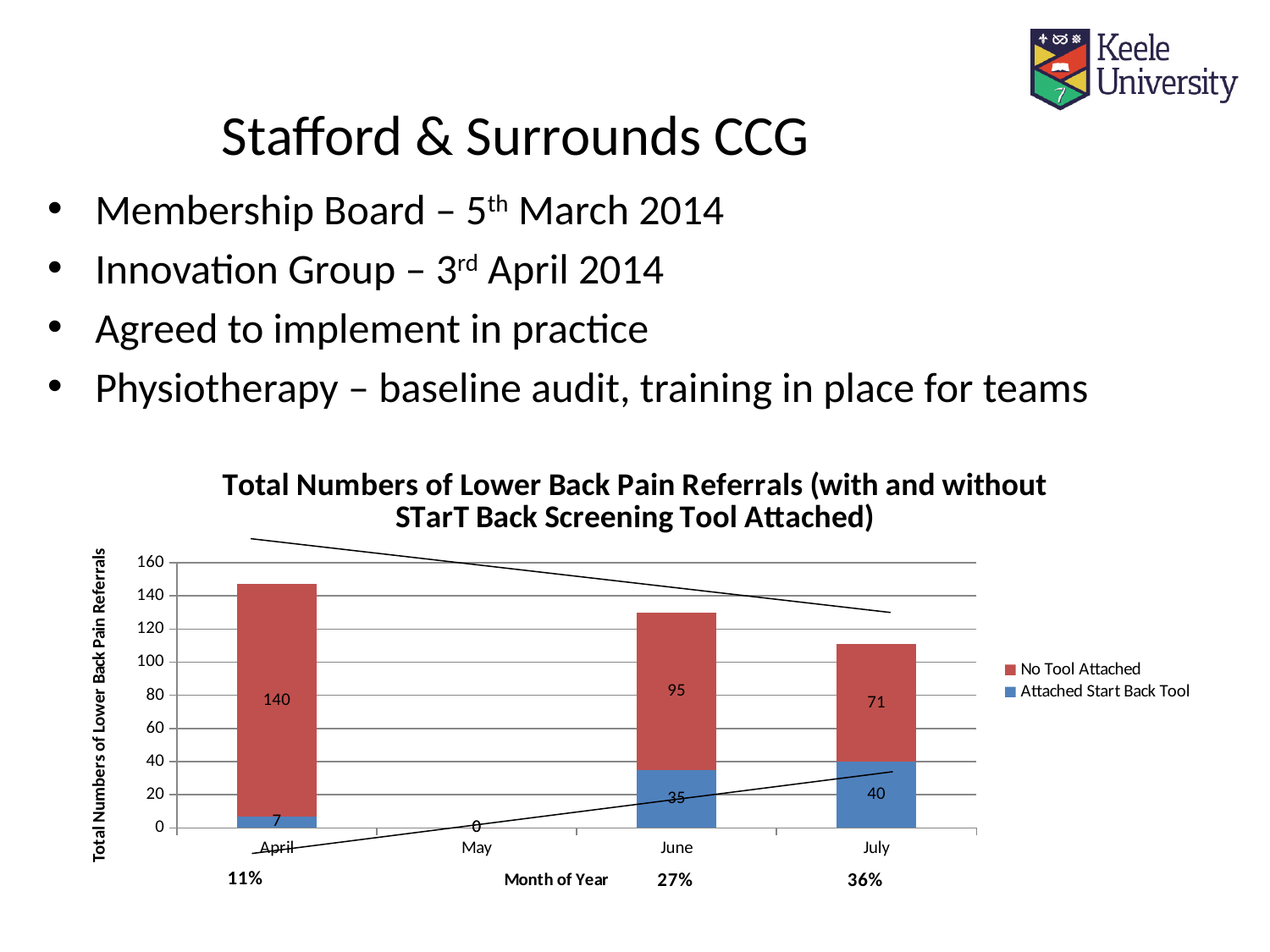
What is the title of the chart? Total Numbers of Lower Back Pain Referrals (with and without STarT Back Screening Tool Attached) What is the value for No Tool Attached in April? 140 How many series does the chart legend list? 2 What kind of chart is shown on the slide? stacked bar chart What is the value for Attached Start Back Tool in July? 40 Which month has the highest value for No Tool Attached? April What is the total of the stacked bar for June? 130 What is the value for No Tool Attached in July? 71 What is the value for Attached Start Back Tool in June? 35 How many months are shown on the x axis of the chart? 4 What is the difference between the No Tool Attached values for June and July? 24 Is the Attached Start Back Tool value for July larger or smaller than the value for April? larger